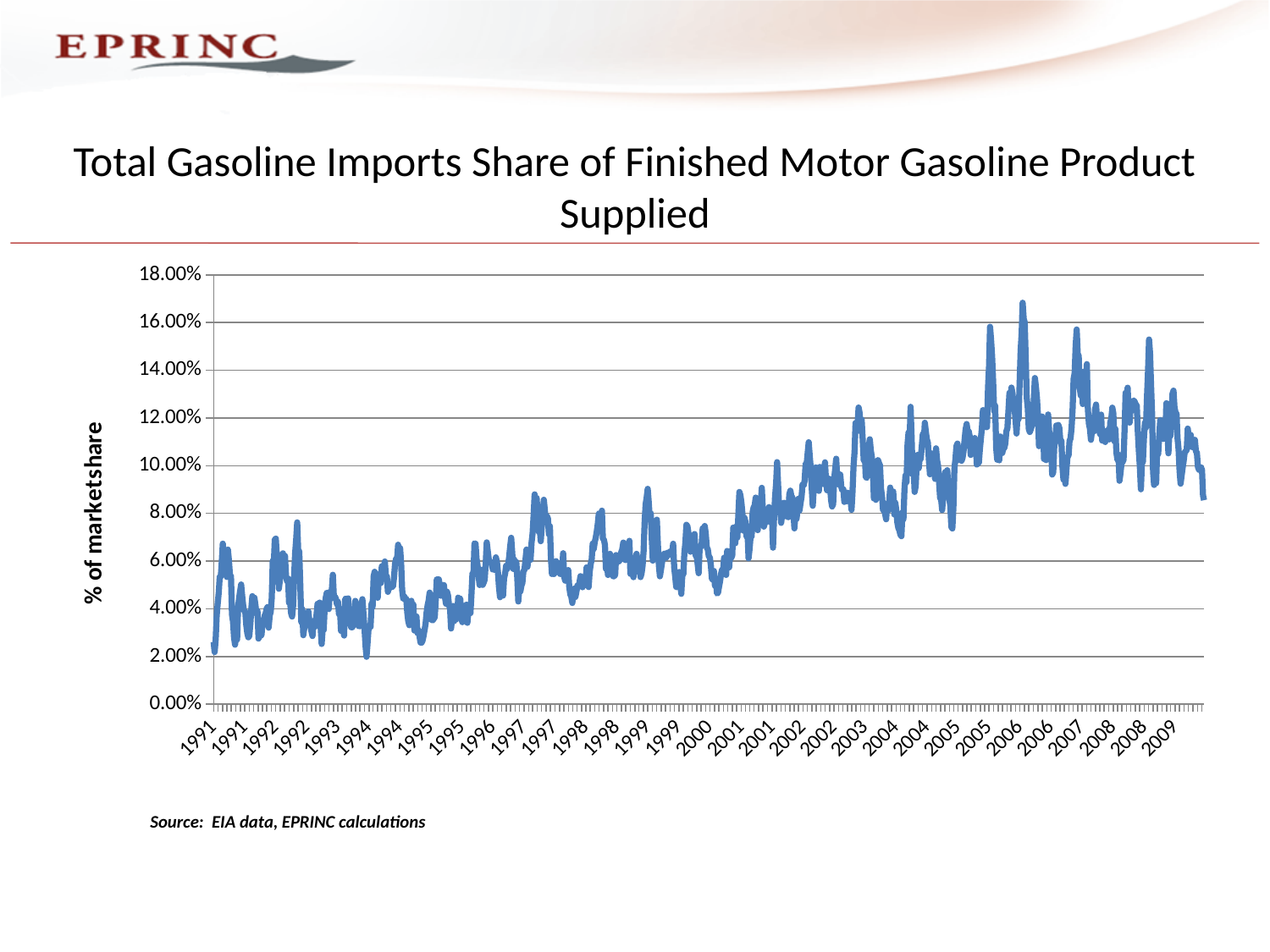
Overall, does the gasoline imports share rise or fall from 1991 to 2009? rise Is the value at the start of the series in 1991 greater or less than 4.00%? less Is the highest peak of the line, around 2006, greater or less than 16.00%? greater Is the value in 2006 larger or smaller than the value in 1991? larger What is the label on the vertical axis of the chart? % of marketshare How many lines are plotted on the chart? 1 Is the value at the end of the series in 2009 greater or less than 6.00%? greater In which year does the line reach its highest peak? 2006 What kind of chart is shown on the slide? line chart What is the title of the chart? Total Gasoline Imports Share of Finished Motor Gasoline Product Supplied What is the maximum value shown on the vertical axis? 18.00%